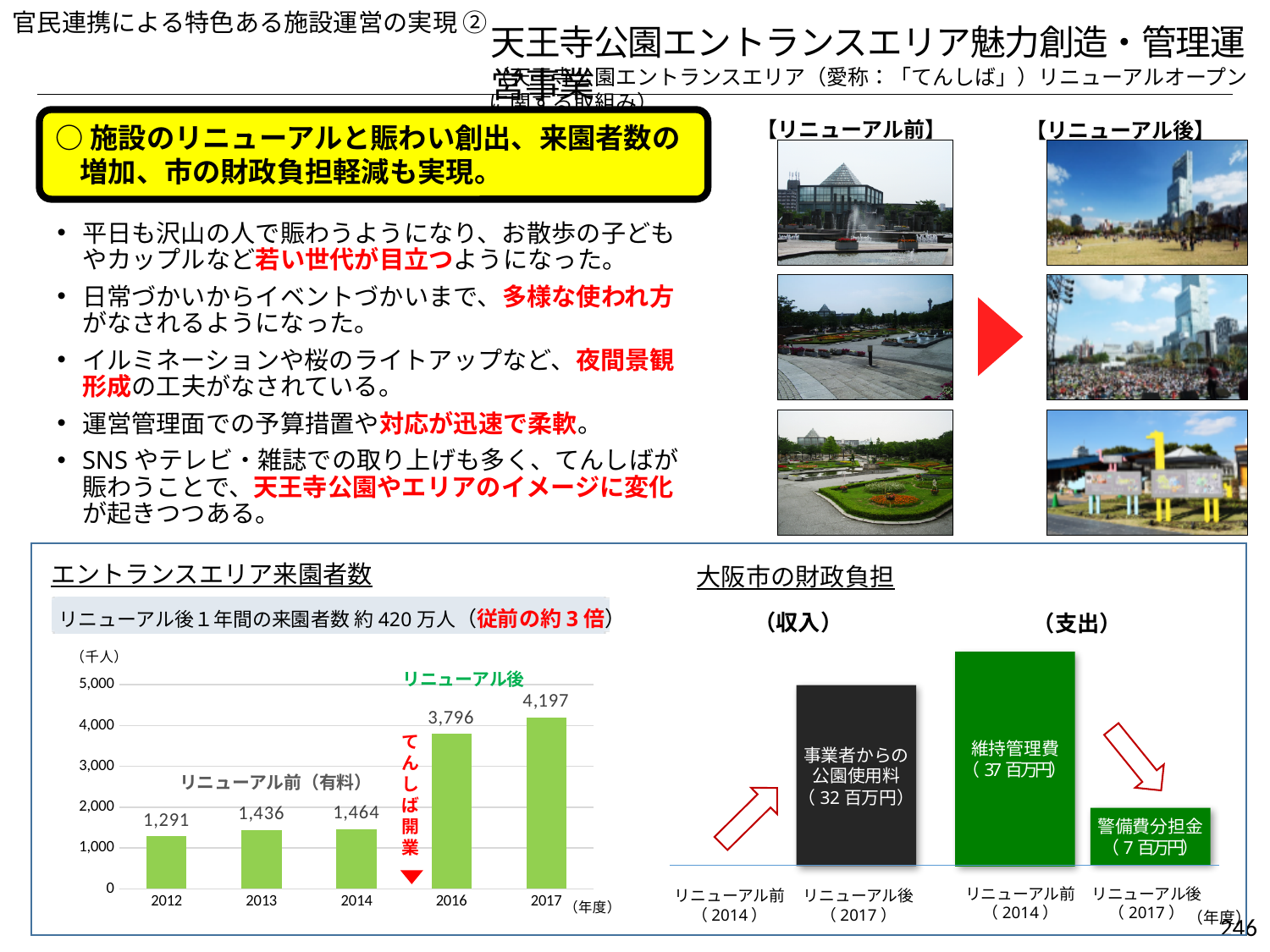
In the エントランスエリア来園者数 chart, which is larger, the value for 2016 or the value for 2014? 2016 In the エントランスエリア来園者数 chart, what is the value for 2016? 3,796 In the エントランスエリア来園者数 chart, do the values rise or fall from 2012 to 2017? rise In the エントランスエリア来園者数 chart, what is the difference between the values for 2014 and 2013? 28 In the エントランスエリア来園者数 chart, how many years are plotted? 5 In the エントランスエリア来園者数 chart, which year has the highest value? 2017 In the エントランスエリア来園者数 chart, what is the value for 2017? 4,197 What type of chart is the エントランスエリア来園者数 chart? bar chart In the エントランスエリア来園者数 chart, which year has the lowest value? 2012 In the エントランスエリア来園者数 chart, what unit is shown on the vertical axis? 千人 In the エントランスエリア来園者数 chart, what is the difference between the values for 2017 and 2016? 401 In the エントランスエリア来園者数 chart, what is the value for 2012? 1,291